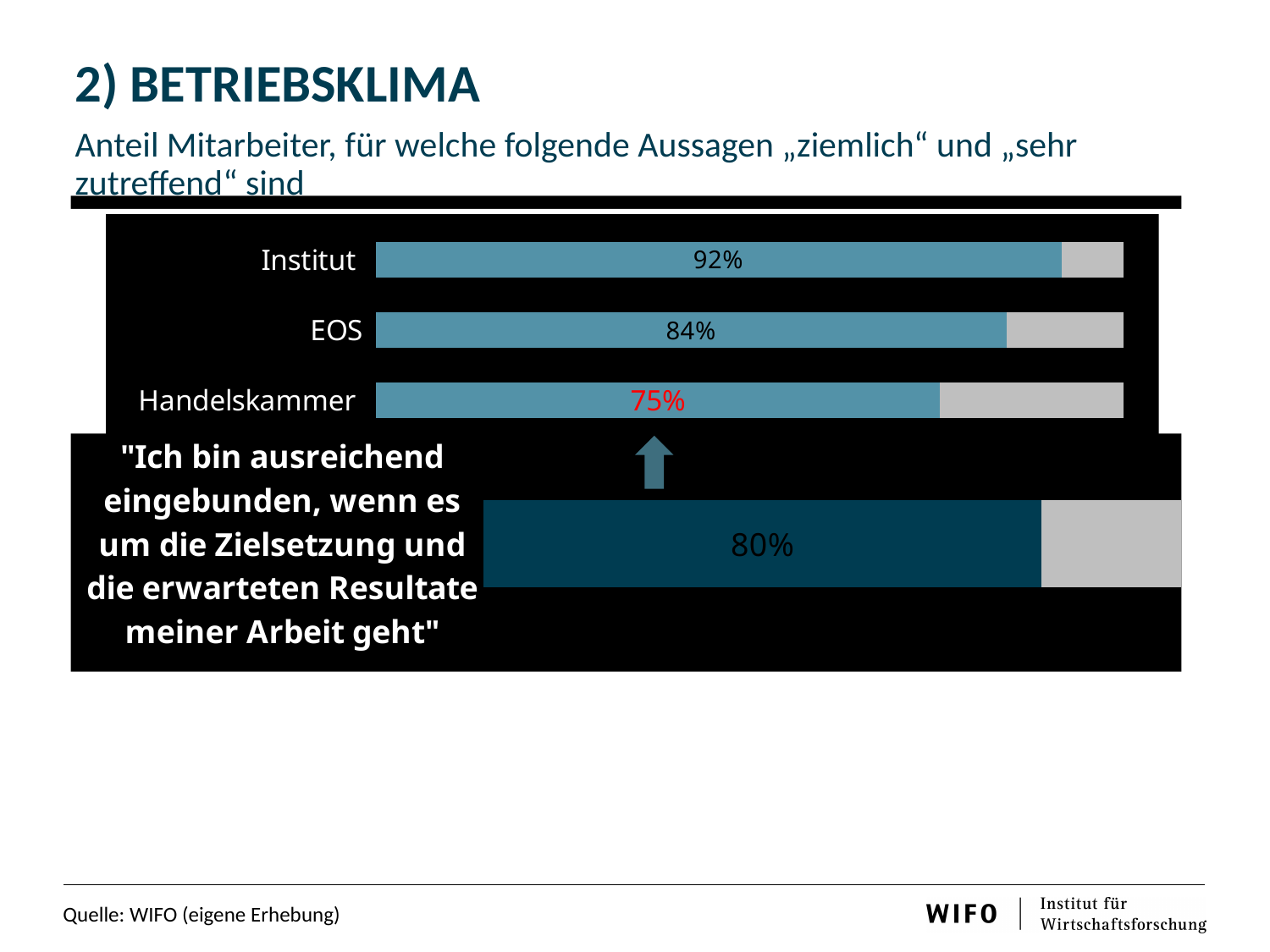
In the upper chart, which is larger, the value for EOS or the value for Handelskammer? EOS In the upper chart, what is the difference between the values for Institut and EOS? 8% How many categories are shown in the upper chart? 3 In the upper chart, what is the value for Handelskammer? 75% What is the value shown on the large bar at the bottom of the slide, next to the statement "Ich bin ausreichend eingebunden..."? 80% In the upper chart, which category has the lowest value? Handelskammer In the upper chart, what is the value for Institut? 92% In the upper chart, what is the value for EOS? 84% In the upper chart, what is the difference between the values for Institut and Handelskammer? 17% In the upper chart, which category's value label is printed in red? Handelskammer What kind of chart is shown on the slide? Bar chart In the upper chart, which category has the highest value? Institut